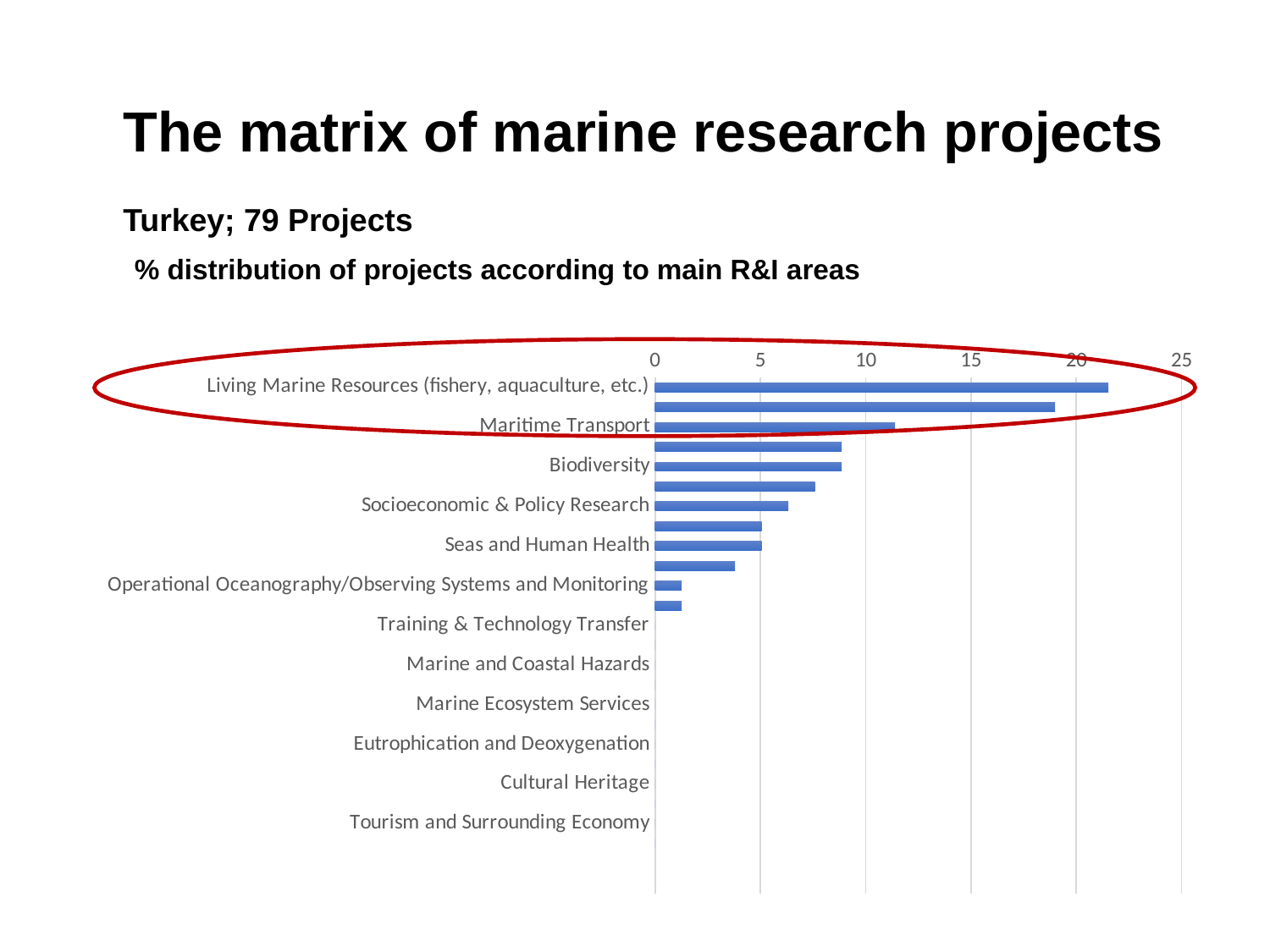
Is the value for Biodiversity greater or less than 10? less How many projects does the slide say the chart covers for Turkey? 79 Is the value for Operational Oceanography/Observing Systems and Monitoring greater or less than 5? less Is the value for Living Marine Resources (fishery, aquaculture, etc.) greater or less than 20? greater What kind of chart is shown on the slide? Bar chart Which category has the longest bar? Living Marine Resources (fishery, aquaculture, etc.) Which is larger, the value for Biodiversity or the value for Socioeconomic & Policy Research? Biodiversity What is the highest value shown on the chart's value axis? 25 Do the bars get longer or shorter going down the chart from top to bottom? shorter Which is larger, the value for Living Marine Resources (fishery, aquaculture, etc.) or the value for Maritime Transport? Living Marine Resources (fishery, aquaculture, etc.)